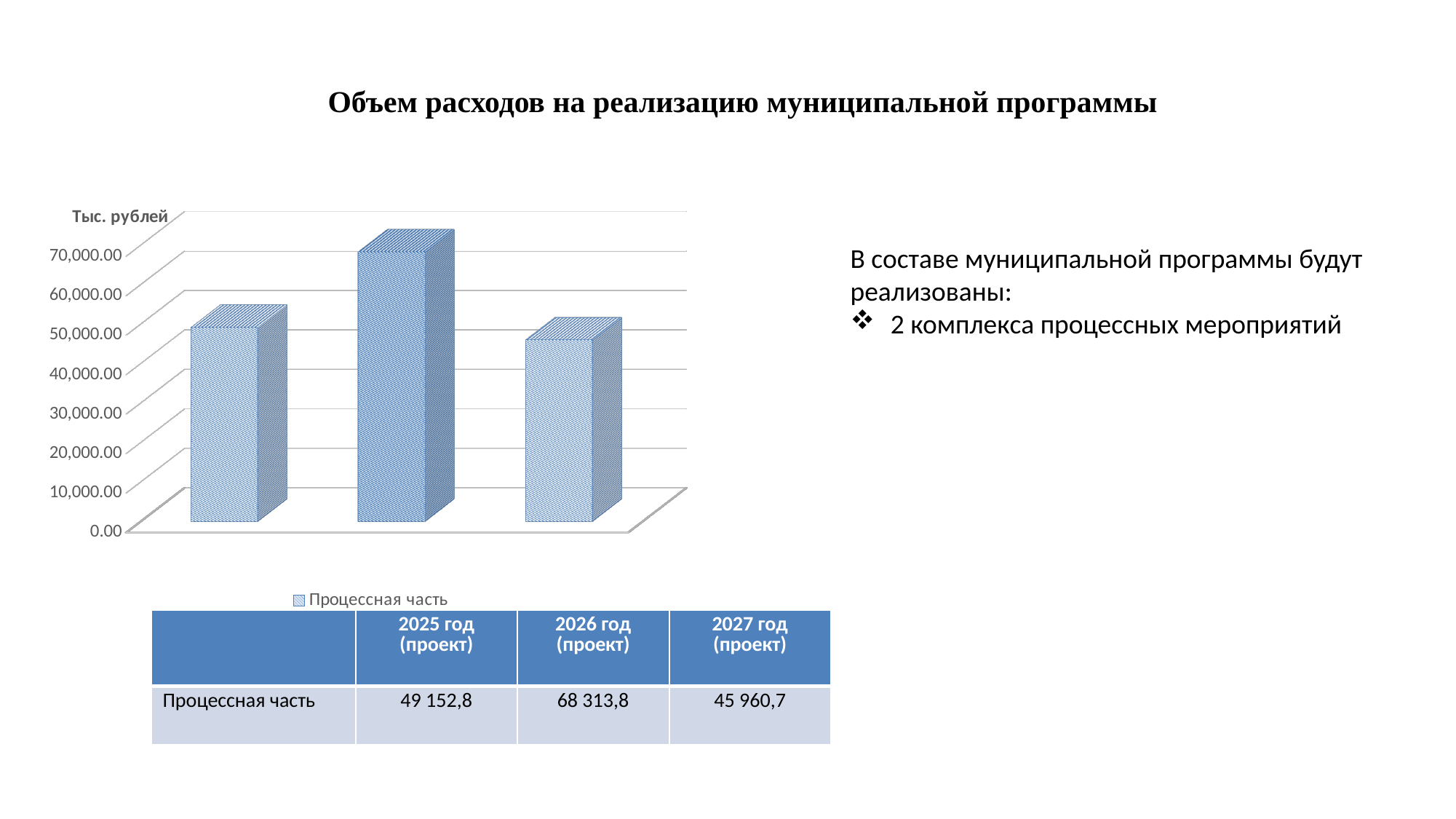
According to the data table, what is the value of Процессная часть for 2026 год (проект)? 68 313,8 Is the value for 2026 год (проект) greater or less than 60,000.00? greater How many series does the chart legend list? 1 What is the name of the series shown in the chart legend? Процессная часть What unit is indicated on the vertical axis of the chart? Тыс. рублей What type of chart is shown on the slide? Bar chart What is the difference between the 2026 and 2025 values of Процессная часть? 19 161,0 Do the values rise or fall from 2026 to 2027? fall How many bars does the chart contain? 3 According to the data table, what is the value of Процессная часть for 2027 год (проект)? 45 960,7 Which year has the highest value of Процессная часть? 2026 год (проект) Which year has the lowest value of Процессная часть? 2027 год (проект)